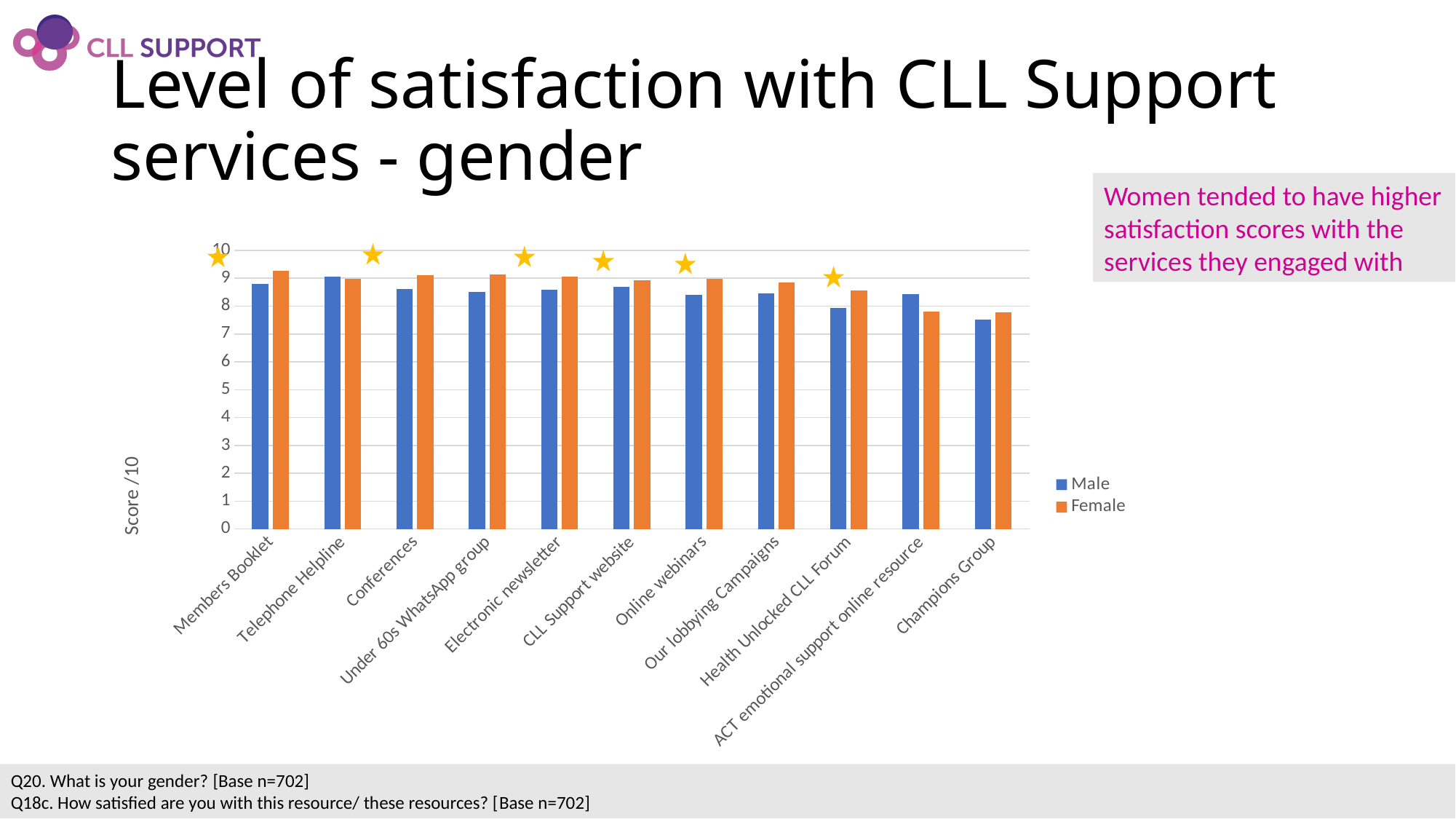
For ACT emotional support online resource, which is higher: the Male score or the Female score? Male How many services (categories) are shown on the x axis of the chart? 11 Is the Male score for Online webinars greater or less than 8? greater Which service has the lowest Male satisfaction score? Champions Group For Members Booklet, which is higher: the Male score or the Female score? Female What are the two series named in the chart legend? Male and Female What is the label on the vertical axis of the chart? Score /10 How many series does the chart legend list? 2 Is the Female score for ACT emotional support online resource greater or less than 8? less What kind of chart is shown on the slide? Bar chart Is the Female score for Members Booklet greater or less than 9? greater